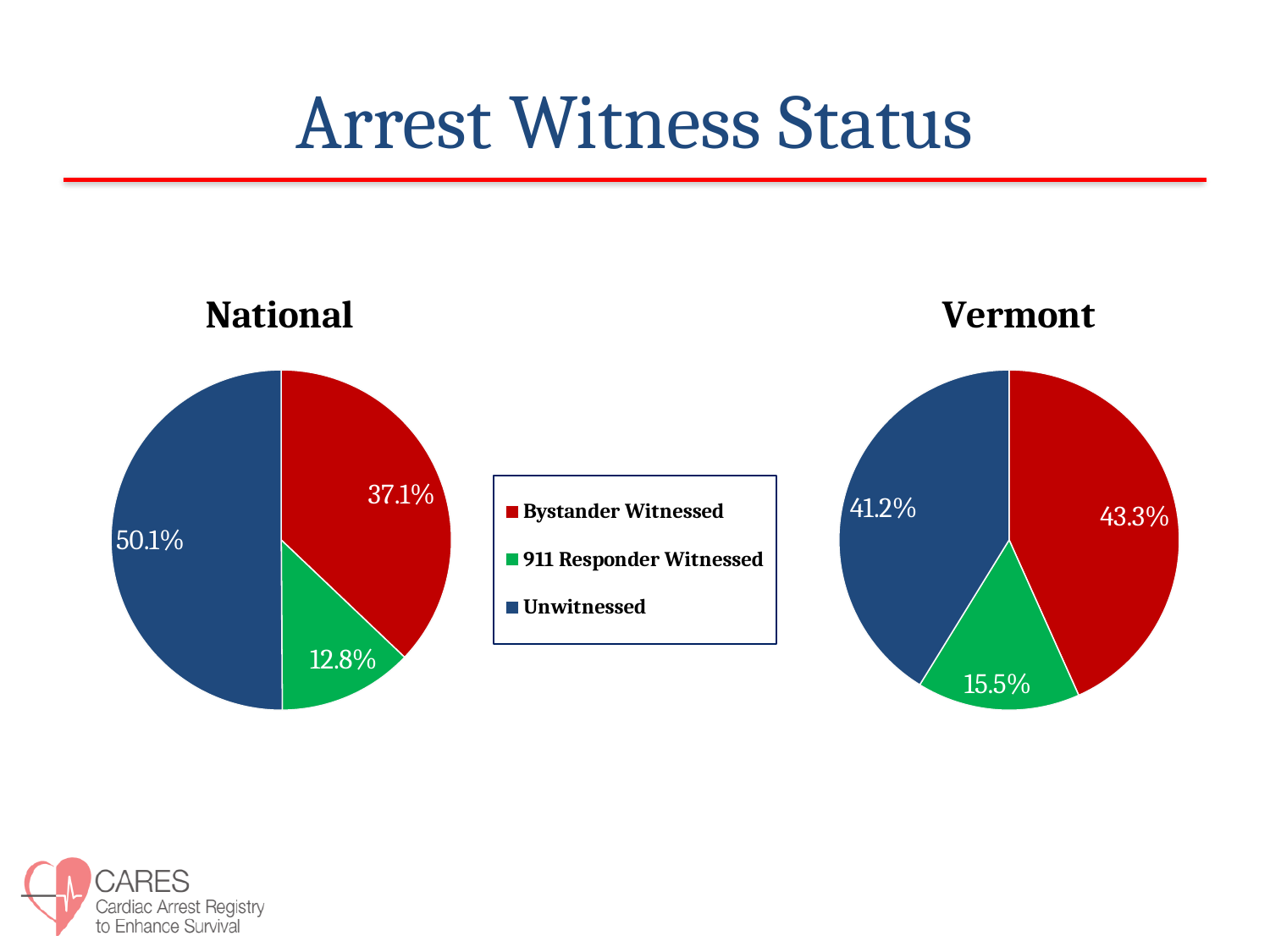
Which colour represents Unwitnessed in the legend? Blue How many categories does the legend list? 3 Which is larger: the 911 Responder Witnessed share in the Vermont chart or in the National chart? Vermont In the National pie chart, what share is 911 Responder Witnessed? 12.8% In the National pie chart, which category has the largest share? Unwitnessed What kind of chart is used for the National and Vermont data? Pie chart In the Vermont pie chart, which category has the largest share? Bystander Witnessed In the Vermont pie chart, what share is Unwitnessed? 41.2% In the National pie chart, what share is Unwitnessed? 50.1% What is the difference between the Bystander Witnessed share in the Vermont chart and in the National chart? 6.2% In the National pie chart, which category has the smallest share? 911 Responder Witnessed In the Vermont pie chart, what share is Bystander Witnessed? 43.3%